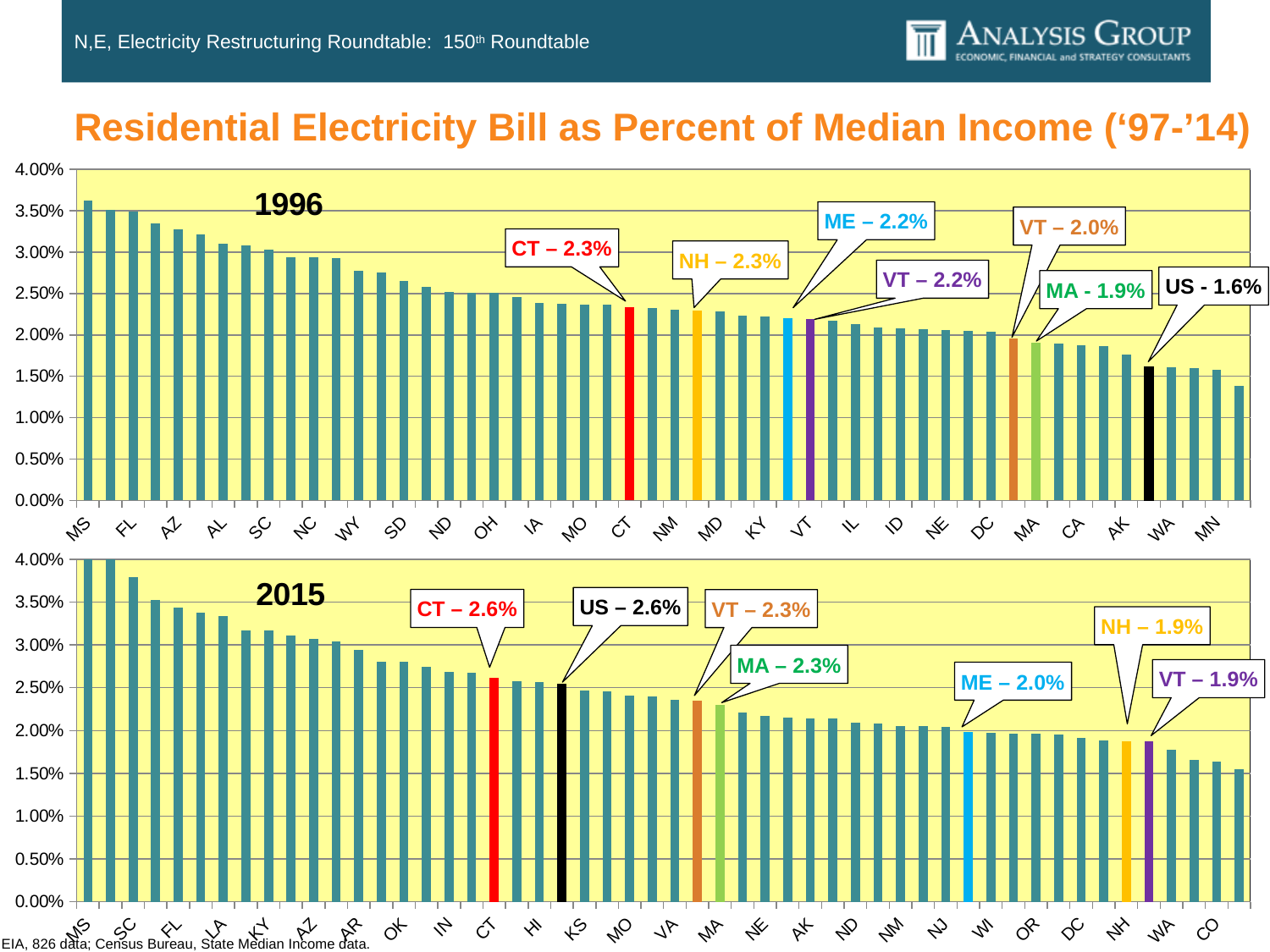
In the 2015 chart, is the value for CO greater or less than 2.00%? less What kind of chart is used on this slide for the 1996 and 2015 data? Bar chart In the 2015 chart, which is larger, the value for CT or the value for MA? CT In the 1996 chart, what is the residential electricity bill as a percent of median income for CT? 2.3% In the 2015 chart, what is the value shown for CT? 2.6% In the 1996 chart, which state has the highest value? MS In the 2015 chart, what is the value shown for ME? 2.0% In the 1996 chart, what is the value shown for MA? 1.9% In the 1996 chart, how much higher is CT's value than the US value? 0.7 percentage points In the 1996 chart, what is the value shown for ME? 2.2% In the 2015 chart, what is the value shown for NH? 1.9% In the 1996 chart, what is the value shown for the US? 1.6%